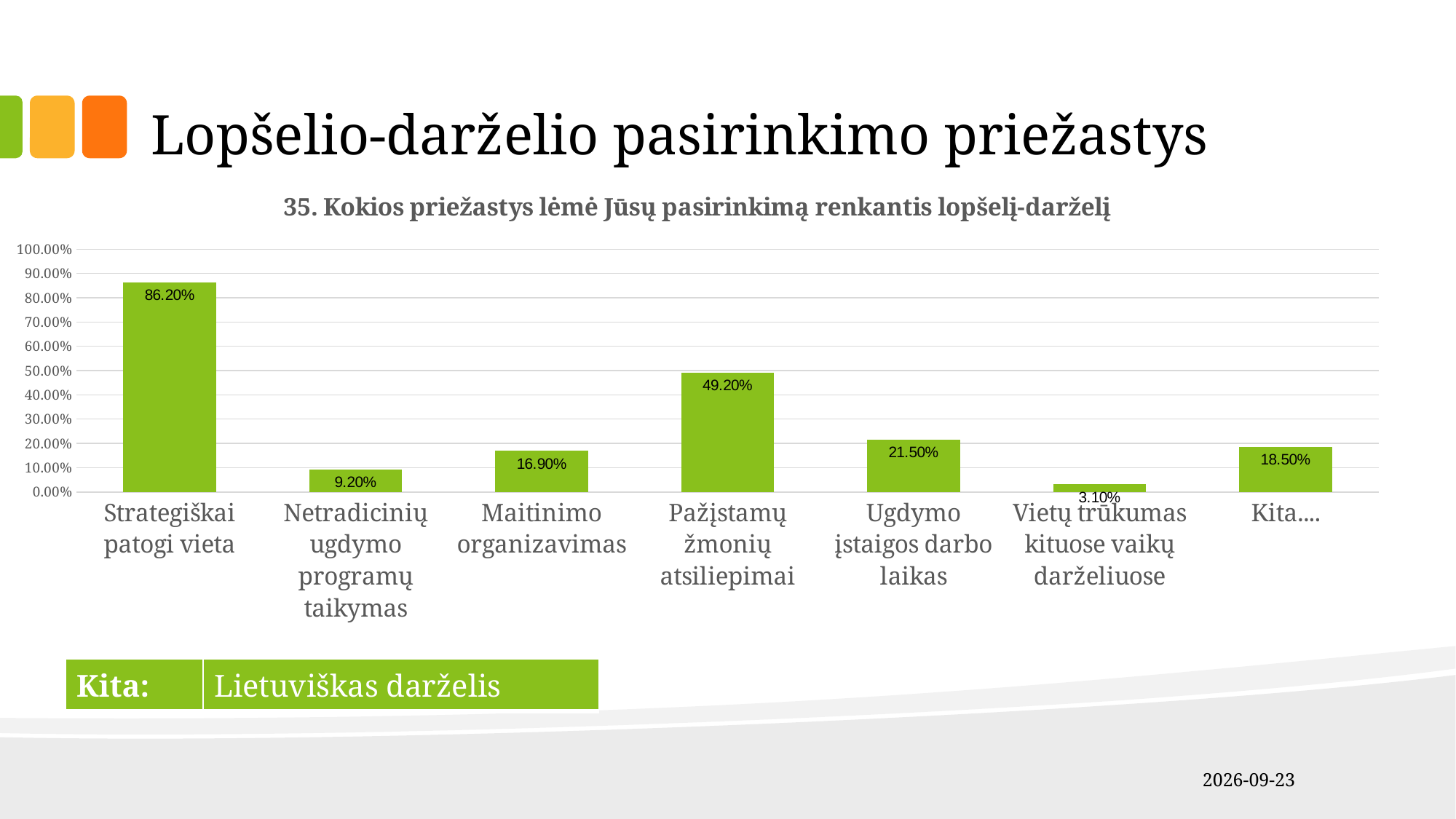
Which is larger, the value for Ugdymo įstaigos darbo laikas or the value for Maitinimo organizavimas? Ugdymo įstaigos darbo laikas Is the value for Netradicinių ugdymo programų taikymas greater or less than 10.00%? less What is the value for Strategiškai patogi vieta? 86.20% What is the value for Vietų trūkumas kituose vaikų darželiuose? 3.10% Which category has the lowest value? Vietų trūkumas kituose vaikų darželiuose How many categories are shown on the x axis? 7 What is the value for Kita....? 18.50% What is the title of the chart? 35. Kokios priežastys lėmė Jūsų pasirinkimą renkantis lopšelį-darželį What is the value for Pažįstamų žmonių atsiliepimai? 49.20% What is the difference between the values for Strategiškai patogi vieta and Pažįstamų žmonių atsiliepimai? 37.00% Which category has the highest value? Strategiškai patogi vieta What kind of chart is shown on the slide? bar chart